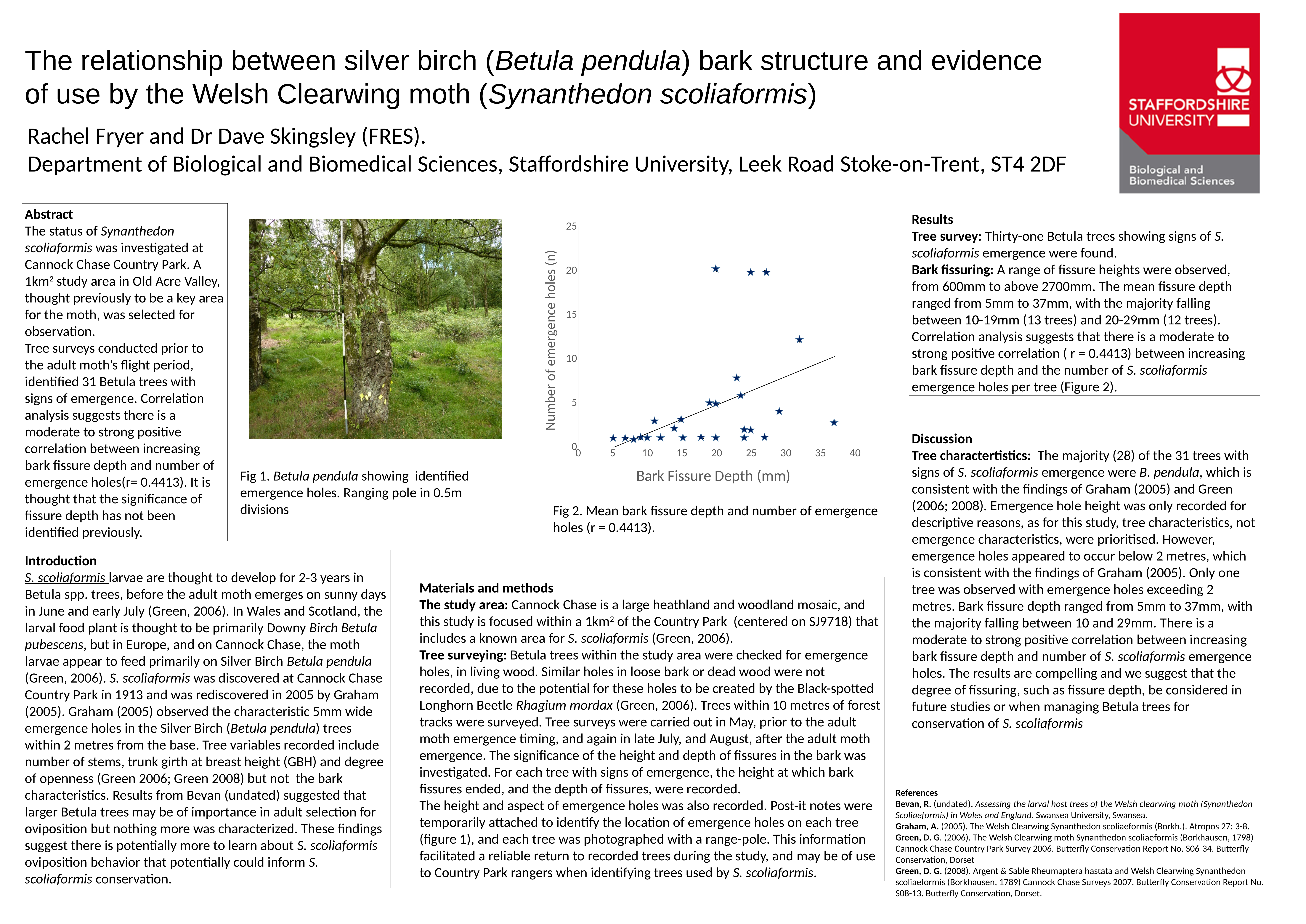
What is the label of the x axis in Fig 2? Bark Fissure Depth (mm) What kind of chart is Fig 2? scatter chart In Fig 2, is the smallest bark fissure depth plotted greater or less than 10? less In Fig 2, is the largest bark fissure depth plotted greater or less than 30? greater In Fig 2, is the highest number of emergence holes plotted greater or less than 15? greater In Fig 2, does the fitted trend line rise or fall as bark fissure depth increases? rises What is the label of the y axis in Fig 2? Number of emergence holes (n)